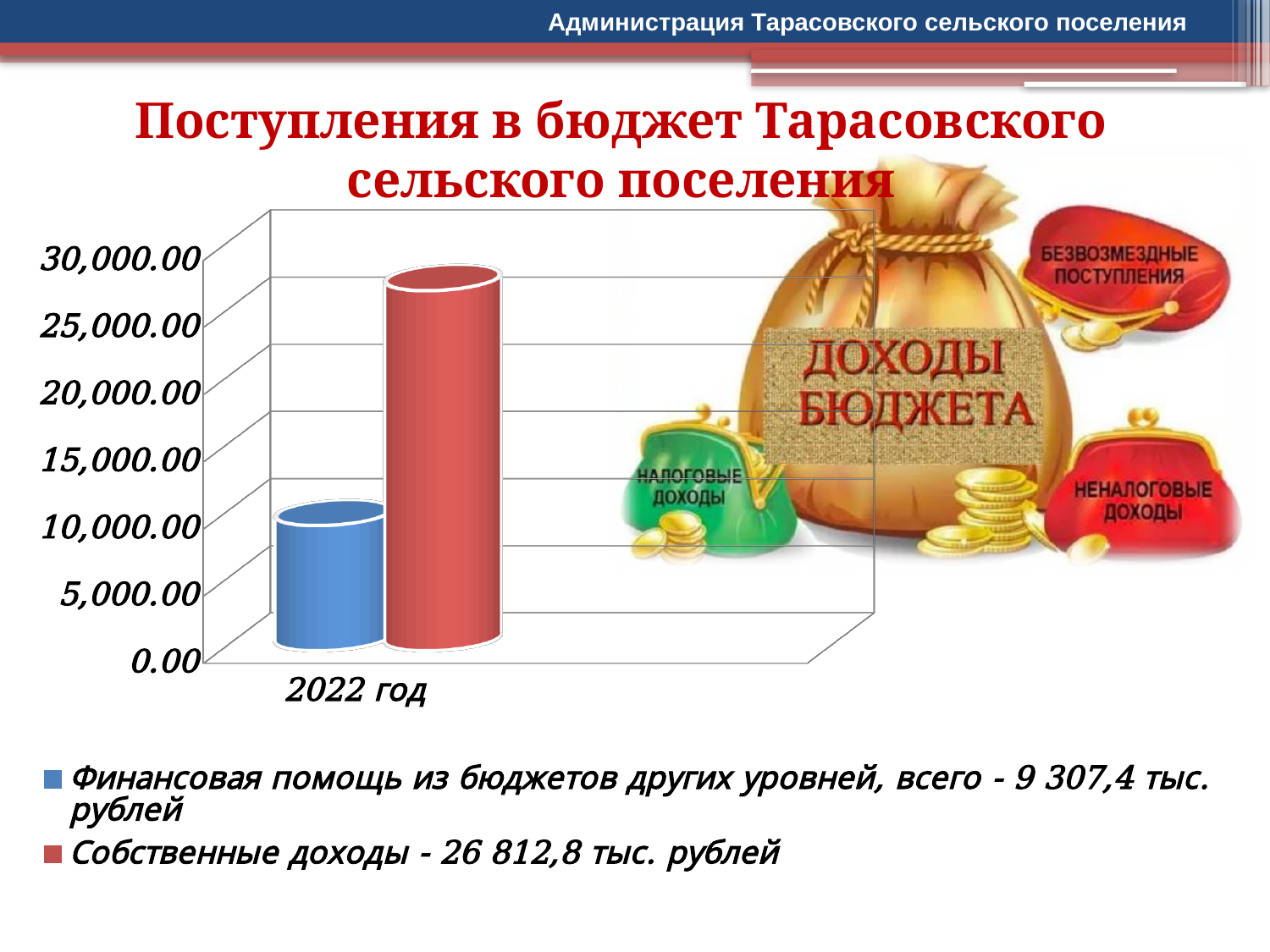
Is the value for Собственные доходы greater or less than 25,000.00? greater What is the difference between Собственные доходы and Финансовая помощь из бюджетов других уровней in 2022 год? 17 505,4 тыс. рублей According to the legend, what is the value for Собственные доходы? 26 812,8 тыс. рублей According to the legend, what is the value for Финансовая помощь из бюджетов других уровней, всего? 9 307,4 тыс. рублей How many series does the chart legend list? 2 What is the category label on the x axis of the chart? 2022 год Which series has the lowest value in the chart? Финансовая помощь из бюджетов других уровней, всего What colour is the bar for Собственные доходы? red Which series has the higher value in 2022 год: Собственные доходы or Финансовая помощь из бюджетов других уровней? Собственные доходы How many categories are shown on the x axis of the chart? 1 Is the value for Финансовая помощь из бюджетов других уровней greater or less than 10,000.00? less What kind of chart is shown on the slide? bar chart